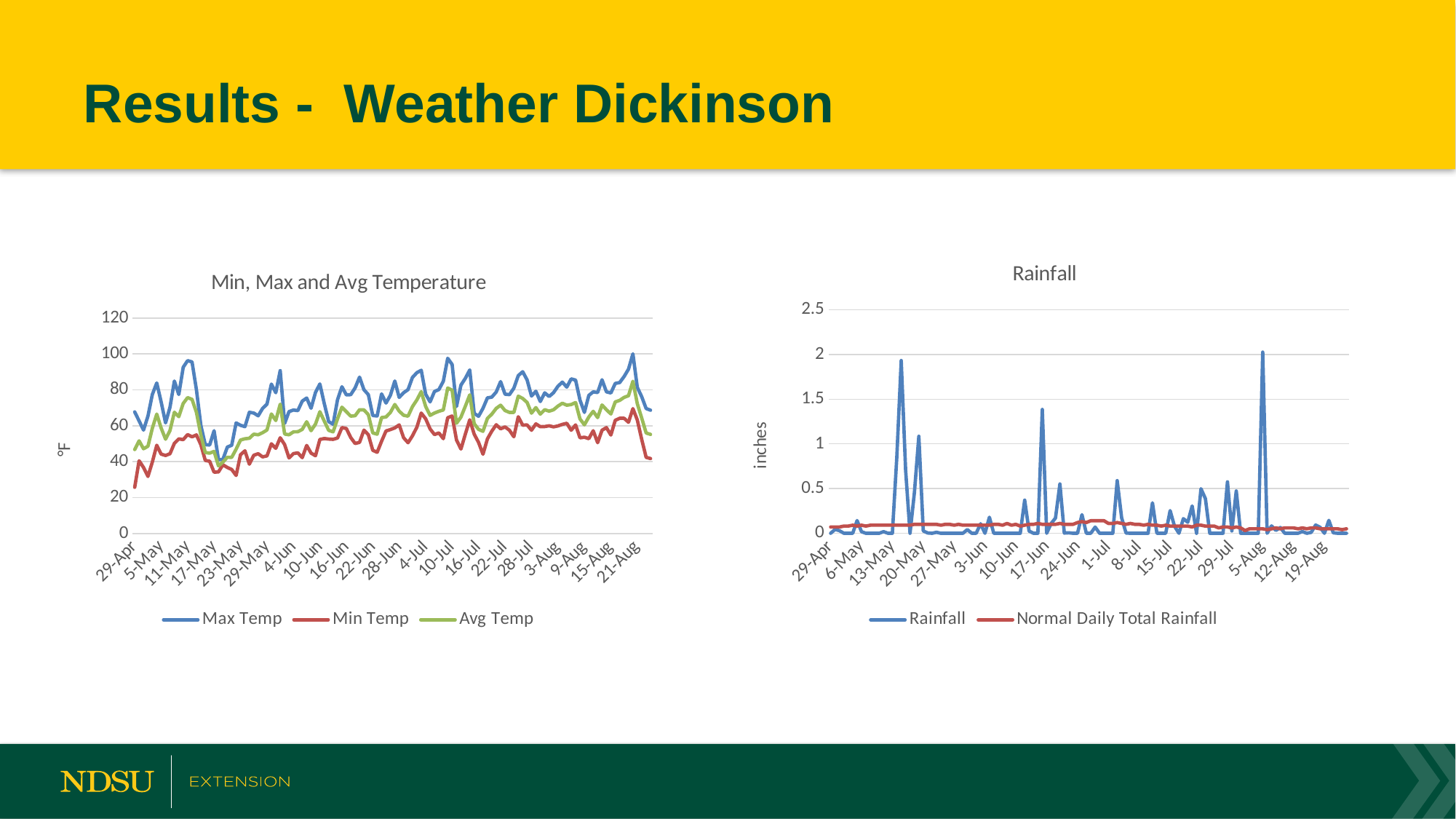
In the "Min, Max and Avg Temperature" chart, which series has the highest values throughout the period, Max Temp or Min Temp? Max Temp In the "Min, Max and Avg Temperature" chart, is the Min Temp value on 29-Apr greater or less than 40? less In the "Rainfall" chart, is the Normal Daily Total Rainfall line ever greater than 0.5? no In the "Min, Max and Avg Temperature" chart, is the Max Temp value on 29-Apr greater or less than 60? greater What kind of chart is the "Min, Max and Avg Temperature" chart? line chart In the "Min, Max and Avg Temperature" chart, which series is plotted in red? Min Temp What kind of chart is the "Rainfall" chart? line chart How many series does the legend of the "Min, Max and Avg Temperature" chart list? 3 What is the y-axis label of the "Rainfall" chart? inches How many series does the legend of the "Rainfall" chart list? 2